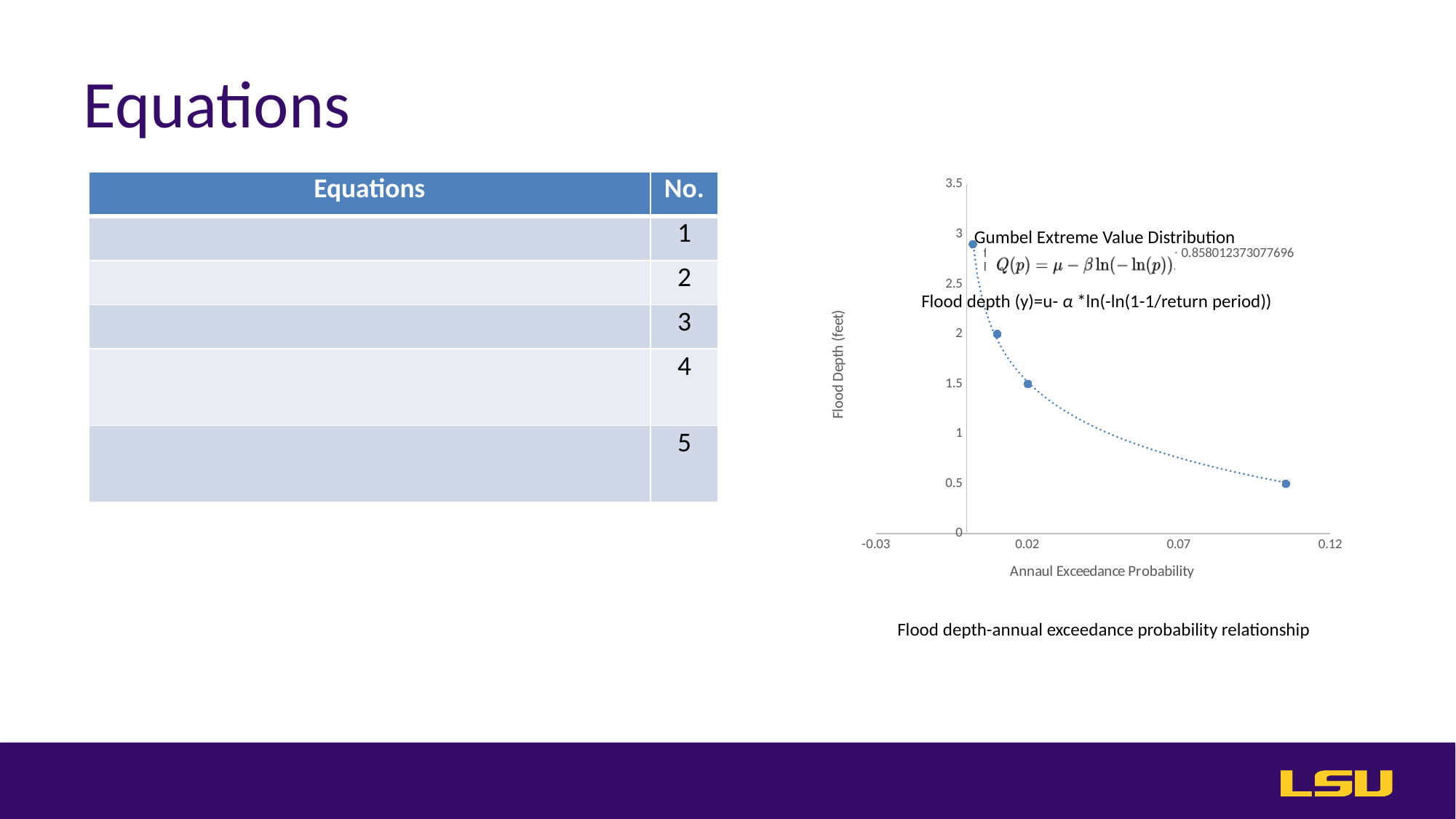
Is the flood depth of the rightmost data point (near 0.1 annual exceedance probability) greater or less than 1? less What is the label of the y axis? Flood Depth (feet) How many data points are plotted on the chart? 4 Is the flood depth of the highest data point greater or less than 2.5? greater Is the flood depth of the data point at about 0.02 annual exceedance probability greater or less than 2? less Which data point has the highest flood depth: the leftmost point or the rightmost point? the leftmost point What is the label of the x axis? Annaul Exceedance Probability What is the maximum value shown on the y axis? 3.5 What kind of chart is shown on the slide? scatter chart Do the flood depth values rise or fall as annual exceedance probability increases along the x axis? fall